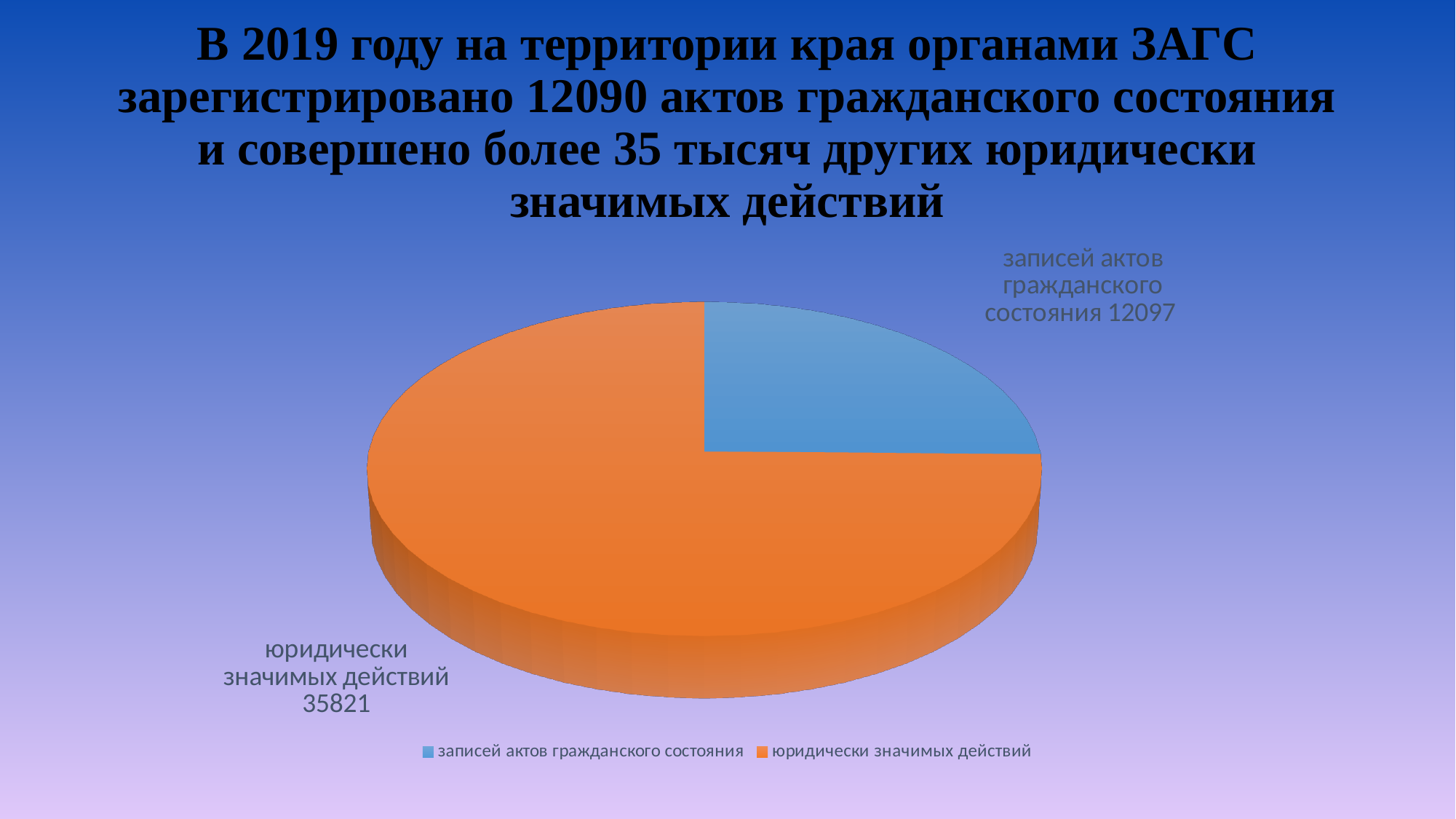
Which slice of the pie chart is the largest? юридически значимых действий What colour is the slice for "юридически значимых действий"? Orange Which is larger: "записей актов гражданского состояния" or "юридически значимых действий"? юридически значимых действий How many entries does the legend list? 2 What colour is the slice for "записей актов гражданского состояния"? Blue Which slice of the pie chart is the smallest? записей актов гражданского состояния What is the total of the two values shown in the pie chart? 47918 How many slices does the pie chart have? 2 What is the difference between the values for "юридически значимых действий" and "записей актов гражданского состояния"? 23724 What is the value for "записей актов гражданского состояния" in the pie chart? 12097 What type of chart is shown on the slide? Pie chart What is the value for "юридически значимых действий" in the pie chart? 35821